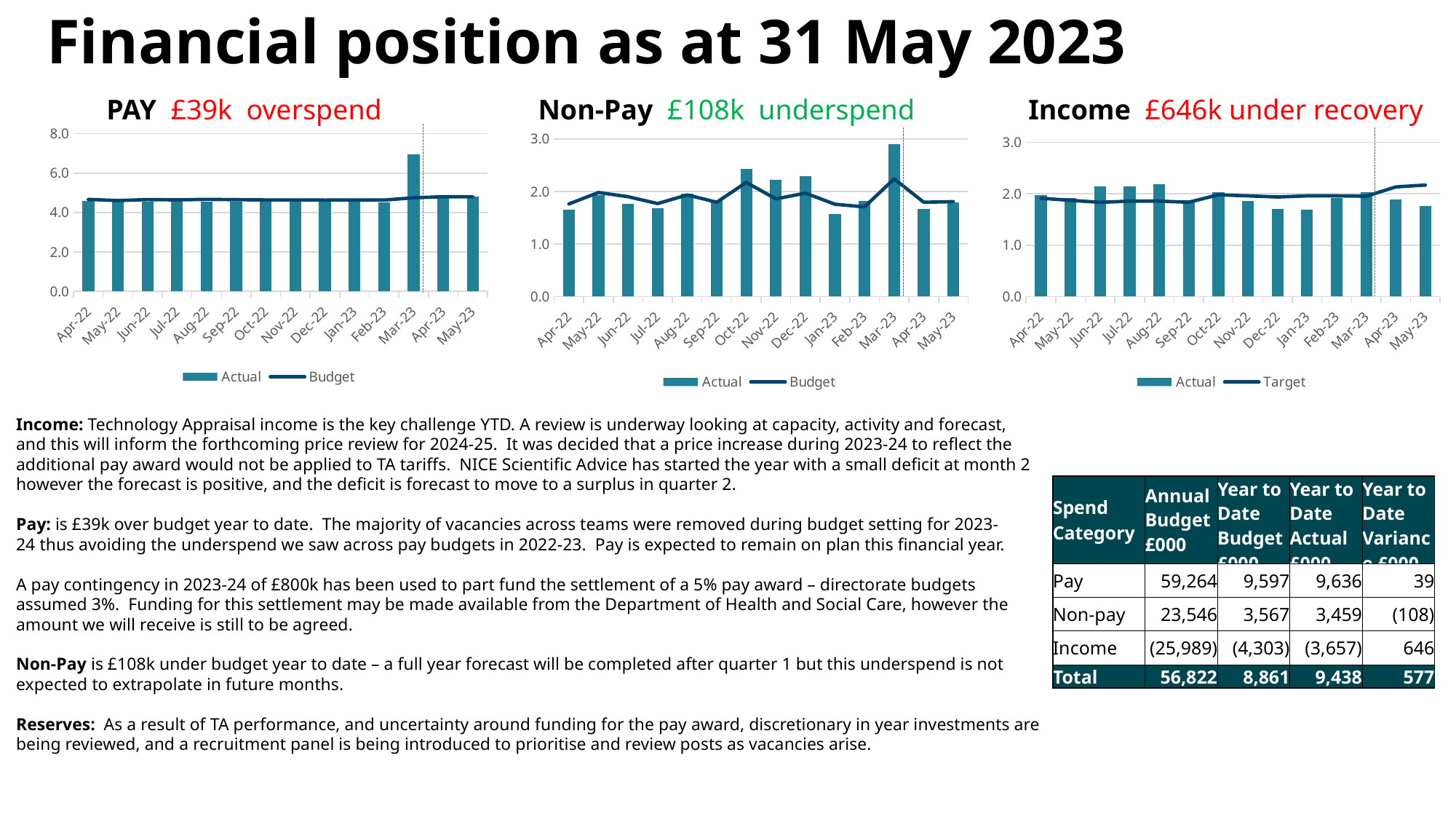
In the Non-Pay chart, which month has the highest Actual bar? Mar-23 How many months are shown on the x axis of the Non-Pay chart? 14 How many series does the legend of the Income chart list? 2 In the Income chart, is the Actual value for Dec-22 greater or less than 2.0? less In the Non-Pay chart, which month has the lowest Actual bar? Jan-23 In the Non-Pay chart, which has the larger Actual bar, Oct-22 or Jan-23? Oct-22 In the PAY chart, which has the larger Actual bar, Mar-23 or Apr-23? Mar-23 In the PAY chart, is the Actual value for Mar-23 greater or less than 6.0? greater In the Non-Pay chart, is the Actual value for Jan-23 greater or less than 2.0? less What are the two legend entries of the Income chart? Actual and Target In the PAY chart, which month has the highest Actual bar? Mar-23 What kind of chart is the PAY chart? combination bar and line chart